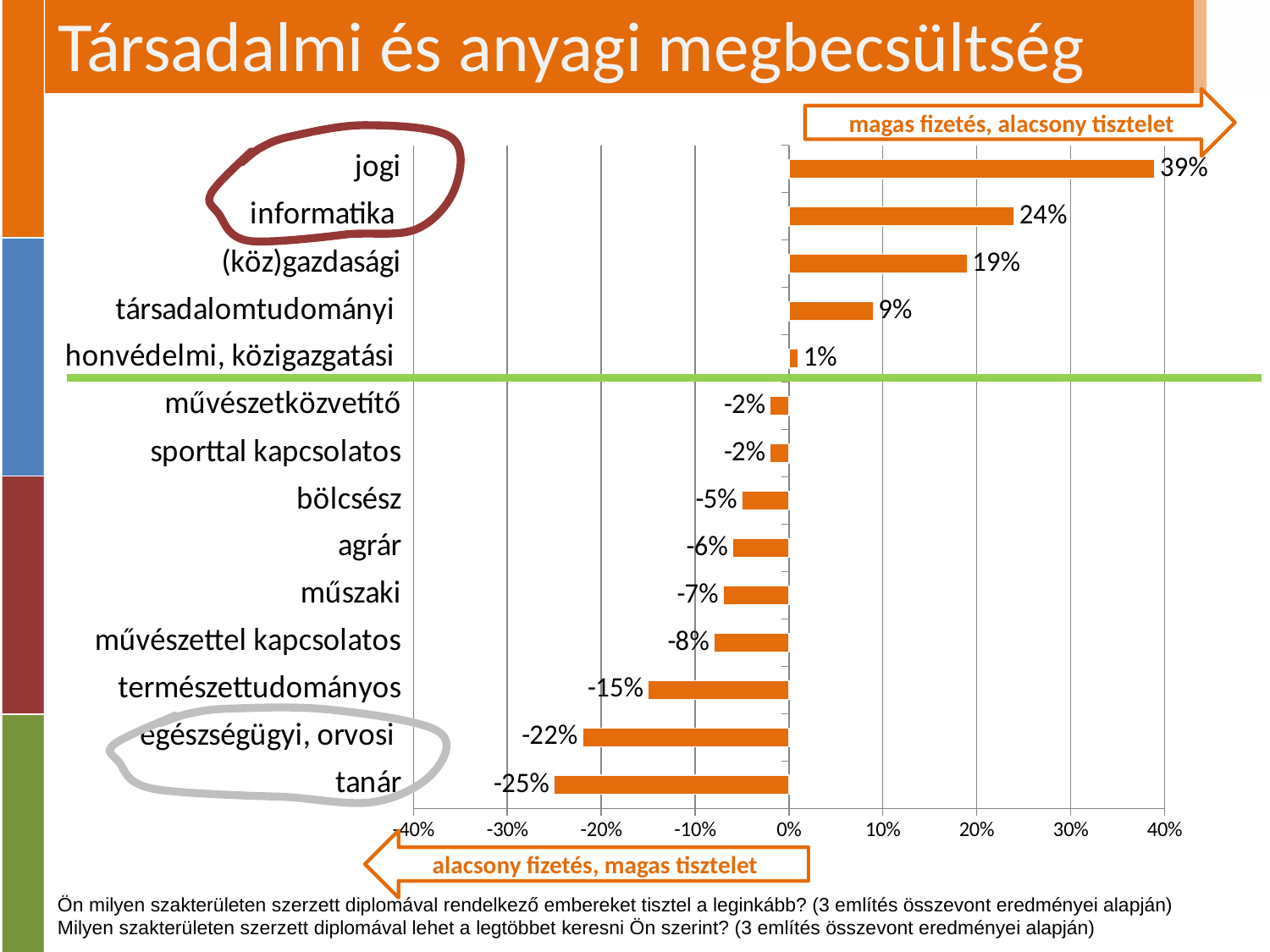
Which category has the lowest value? tanár What is the difference between the values for egészségügyi, orvosi and tanár? 3% What is the difference between the values for jogi and informatika? 15% What is the value for természettudományos? -15% How many categories are shown in the chart? 14 What is the value for tanár? -25% Which category has the highest value? jogi Which is larger, the value for (köz)gazdasági or the value for társadalomtudományi? (köz)gazdasági What is the value for jogi? 39% What kind of chart is shown on the slide? bar chart What is the value for informatika? 24% What is the title of the slide containing the chart? Társadalmi és anyagi megbecsültség